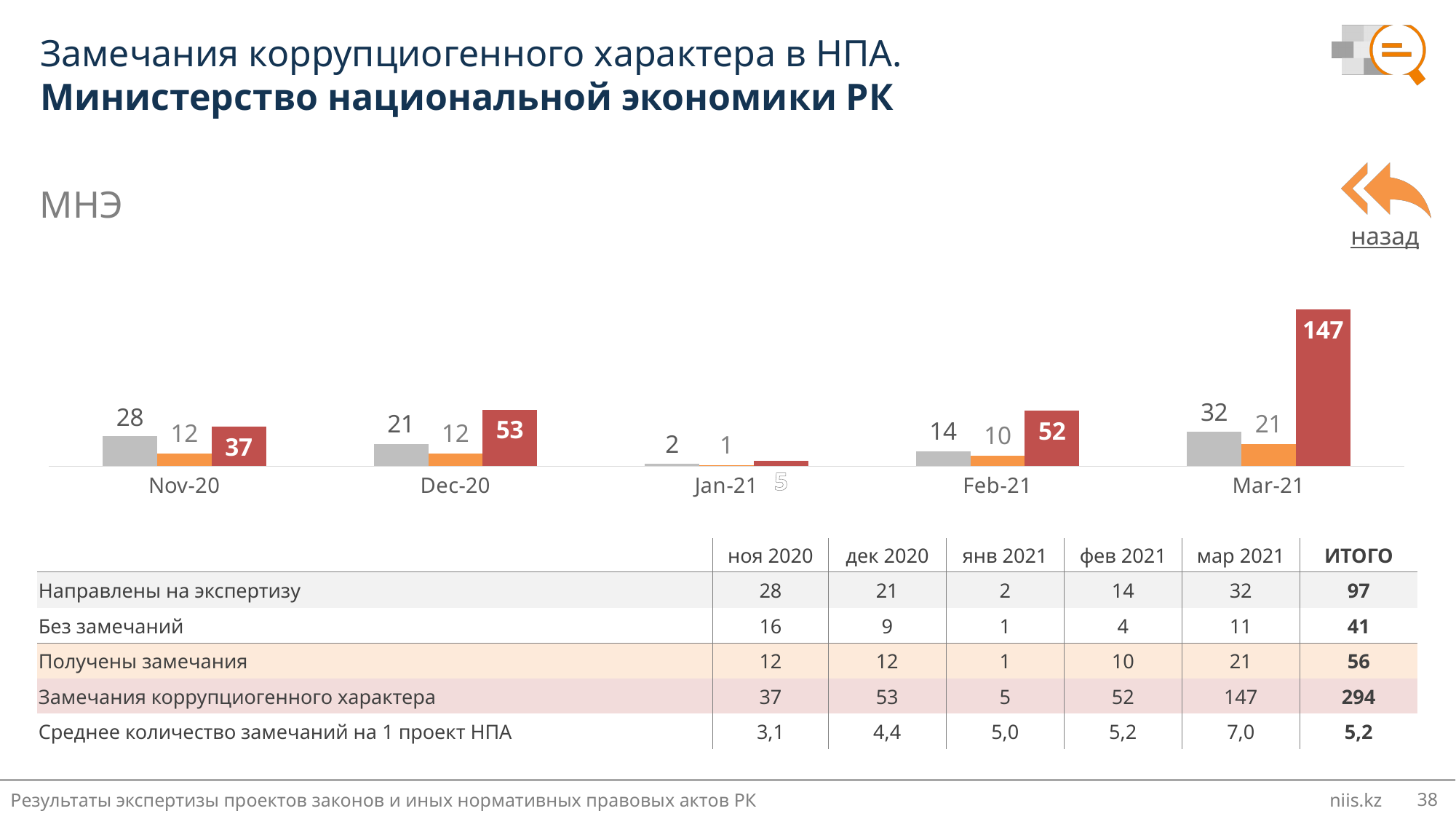
What is the value of the red bar for Dec-20? 53 Which is larger, the grey bar for Nov-20 or the grey bar for Mar-21? Mar-21 What type of chart is shown on the slide? bar chart How many bars are shown for each month in the chart? 3 What is the value of the orange bar for Feb-21? 10 Which month has the lowest grey bar? Jan-21 What is the value of the red bar for Mar-21? 147 How many months are shown on the x axis of the chart? 5 What is the difference between the red bar values for Mar-21 and Feb-21? 95 Which month has the highest red bar? Mar-21 What is the value of the grey bar for Nov-20? 28 What colour are the bars representing 'Замечания коррупциогенного характера'? red